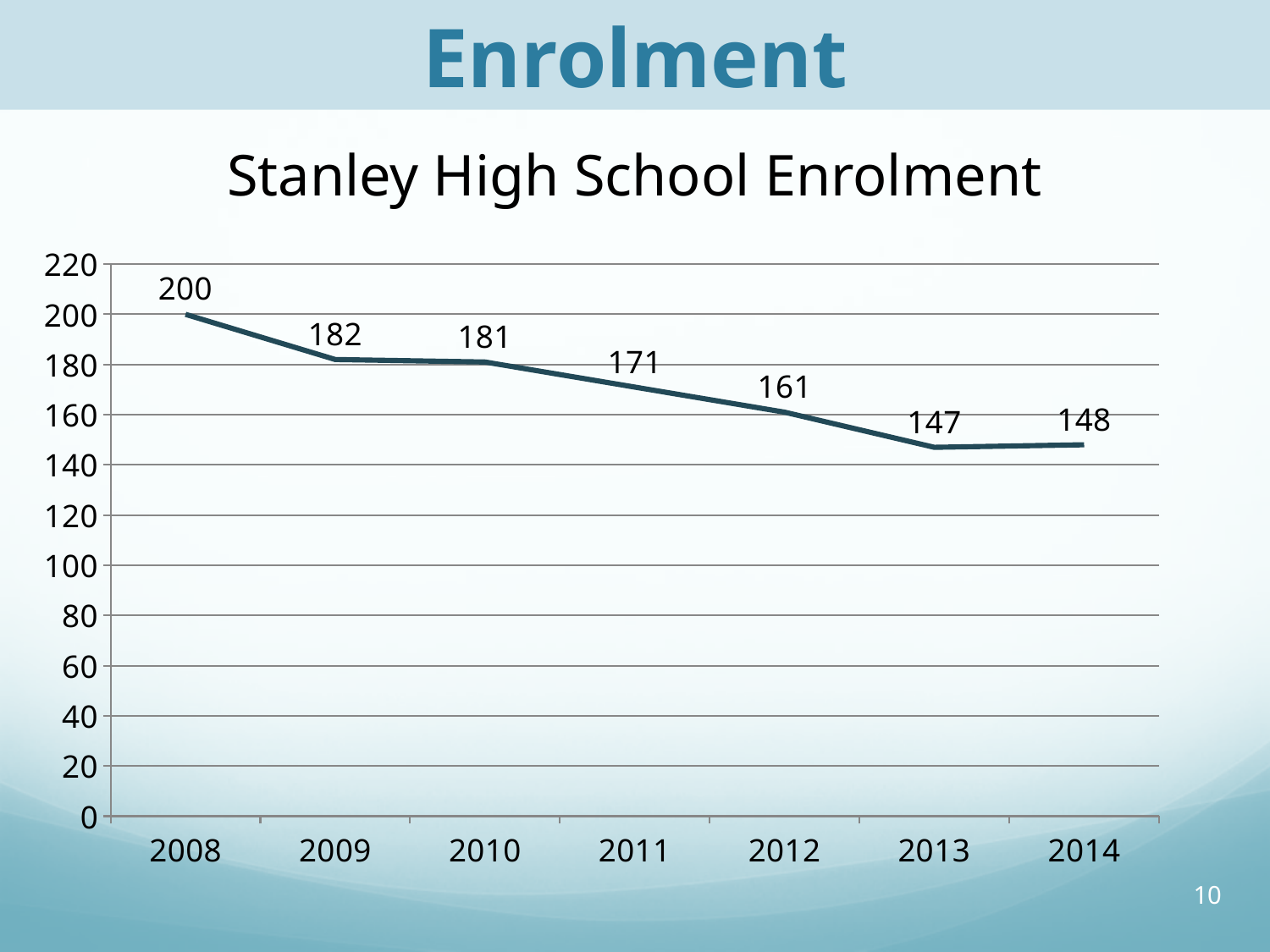
How many years are plotted on the chart? 7 By how much did enrolment fall from 2008 to 2014? 52 What is the overall trend in enrolment from 2008 to 2014? falling What was the enrolment at Stanley High School in 2008? 200 Is the enrolment for 2012 greater or less than 180? less Which year had higher enrolment, 2009 or 2012? 2009 Which year had the highest enrolment? 2008 What was the enrolment in 2011? 171 What kind of chart is shown on the slide? line chart What is the difference in enrolment between 2011 and 2012? 10 What was the enrolment in 2014? 148 Which year had the lowest enrolment? 2013